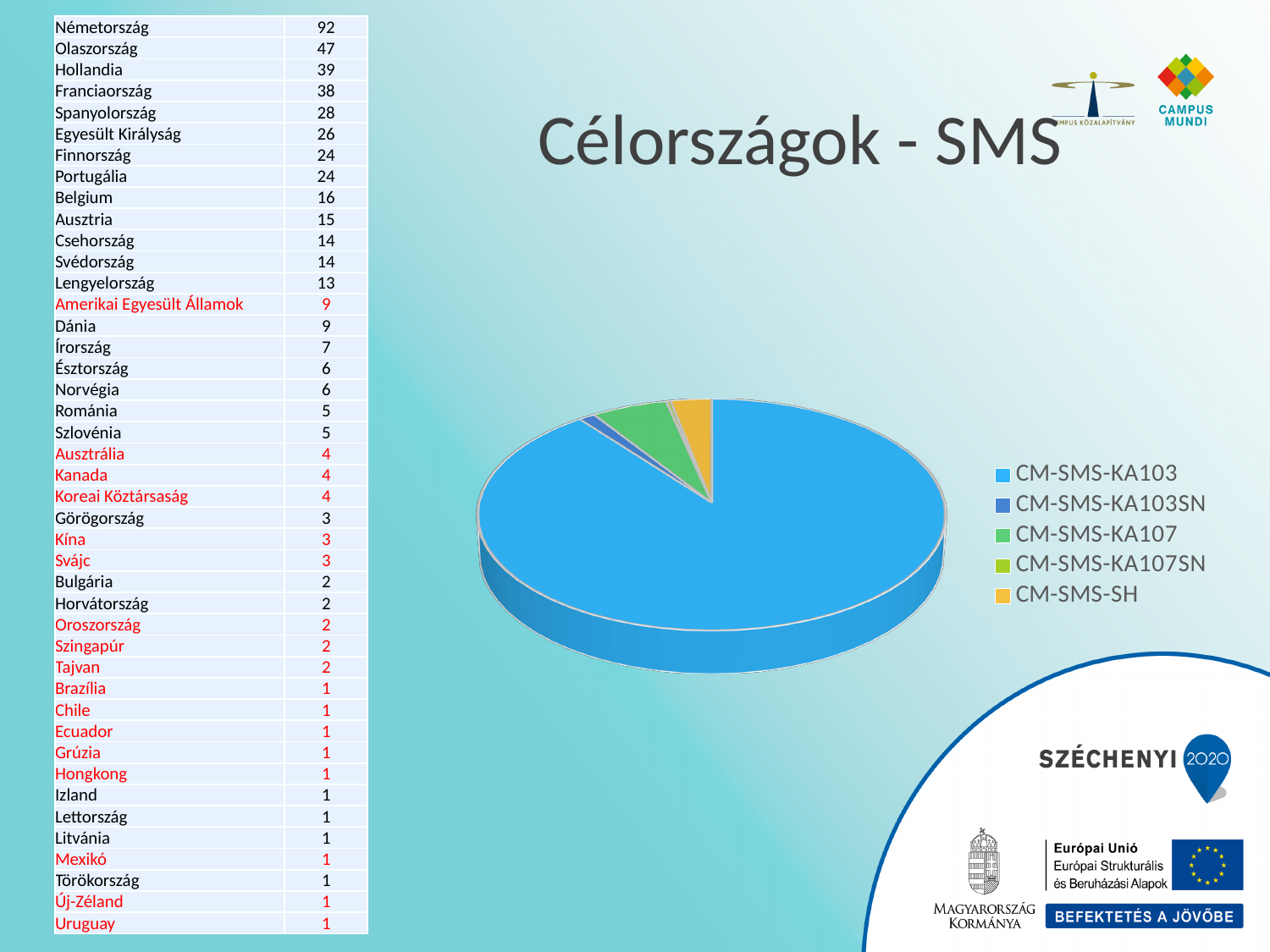
What is the title of the slide containing the pie chart? Célországok - SMS Which slice is larger in the pie chart, CM-SMS-SH or CM-SMS-KA103SN? CM-SMS-SH Which legend entry of the pie chart is shown in yellow? CM-SMS-SH How many series does the legend of the pie chart list? 5 Which slice is larger in the pie chart, CM-SMS-KA103 or CM-SMS-KA107? CM-SMS-KA103 Which slice is larger in the pie chart, CM-SMS-KA107 or CM-SMS-KA103SN? CM-SMS-KA107 What kind of chart is shown on the slide? pie chart Which series has the largest slice in the pie chart? CM-SMS-KA103